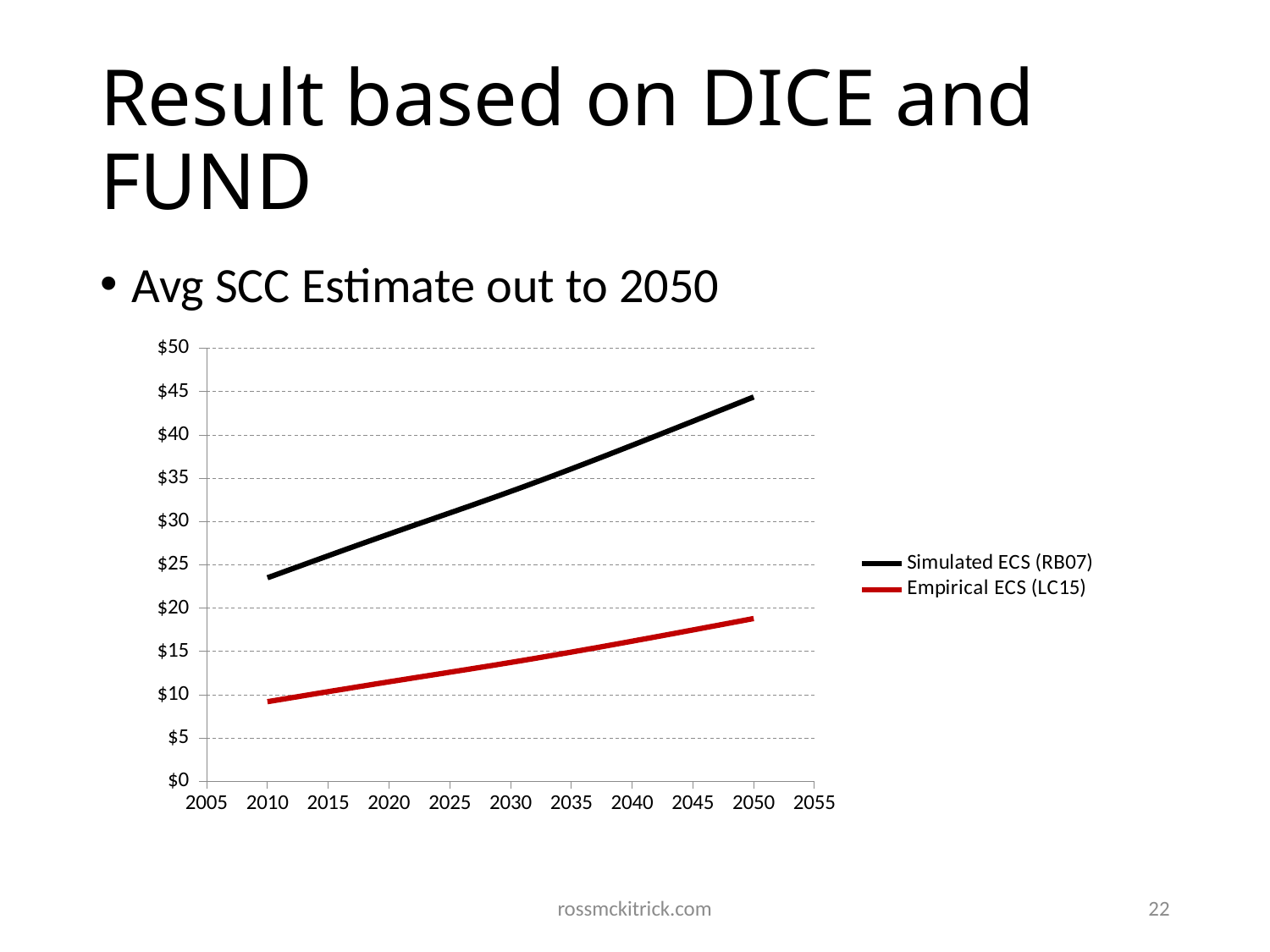
Is the value for Simulated ECS (RB07) in 2010 greater or less than $25? less Is the value for Empirical ECS (LC15) in 2010 greater or less than $10? less Is the value for Empirical ECS (LC15) in 2050 greater or less than $20? less How many series does the chart legend list? 2 What colour is the line for Empirical ECS (LC15)? red Do the values for Empirical ECS (LC15) rise or fall from 2010 to 2050? rise Do the values for Simulated ECS (RB07) rise or fall from 2010 to 2050? rise Which series has the higher values throughout the chart, Simulated ECS (RB07) or Empirical ECS (LC15)? Simulated ECS (RB07) What kind of chart is shown on the slide? line chart What is the highest value shown on the chart's vertical axis? $50